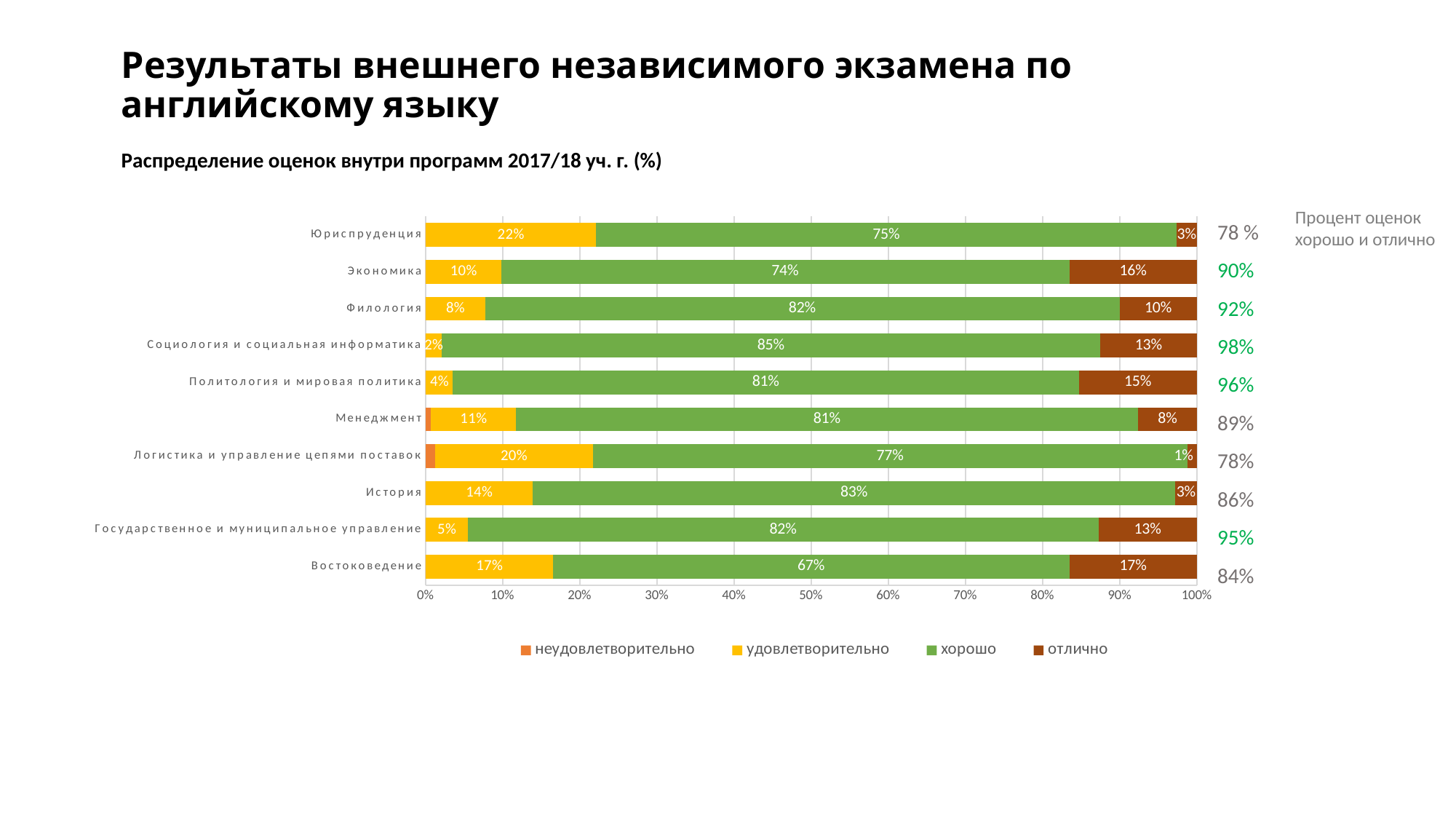
What is the удовлетворительно value for Юриспруденция? 22% What percentage of grades for Экономика are отлично? 16% What is the value of the хорошо series for Филология? 82% Which program has the lowest share of хорошо grades? Востоковедение Which program has the highest share of отлично grades? Востоковедение Which has a larger удовлетворительно share: Логистика и управление цепями поставок or История? Логистика и управление цепями поставок How many programs are shown in the chart? 10 What is the combined share of хорошо and отлично grades for Политология и мировая политика? 96% How many series does the legend list? 4 What kind of chart is shown on the slide? Stacked bar chart Which program has the highest share of хорошо grades? Социология и социальная информатика What is the difference in percentage points between the отлично share for Востоковедение and for Менеджмент? 9